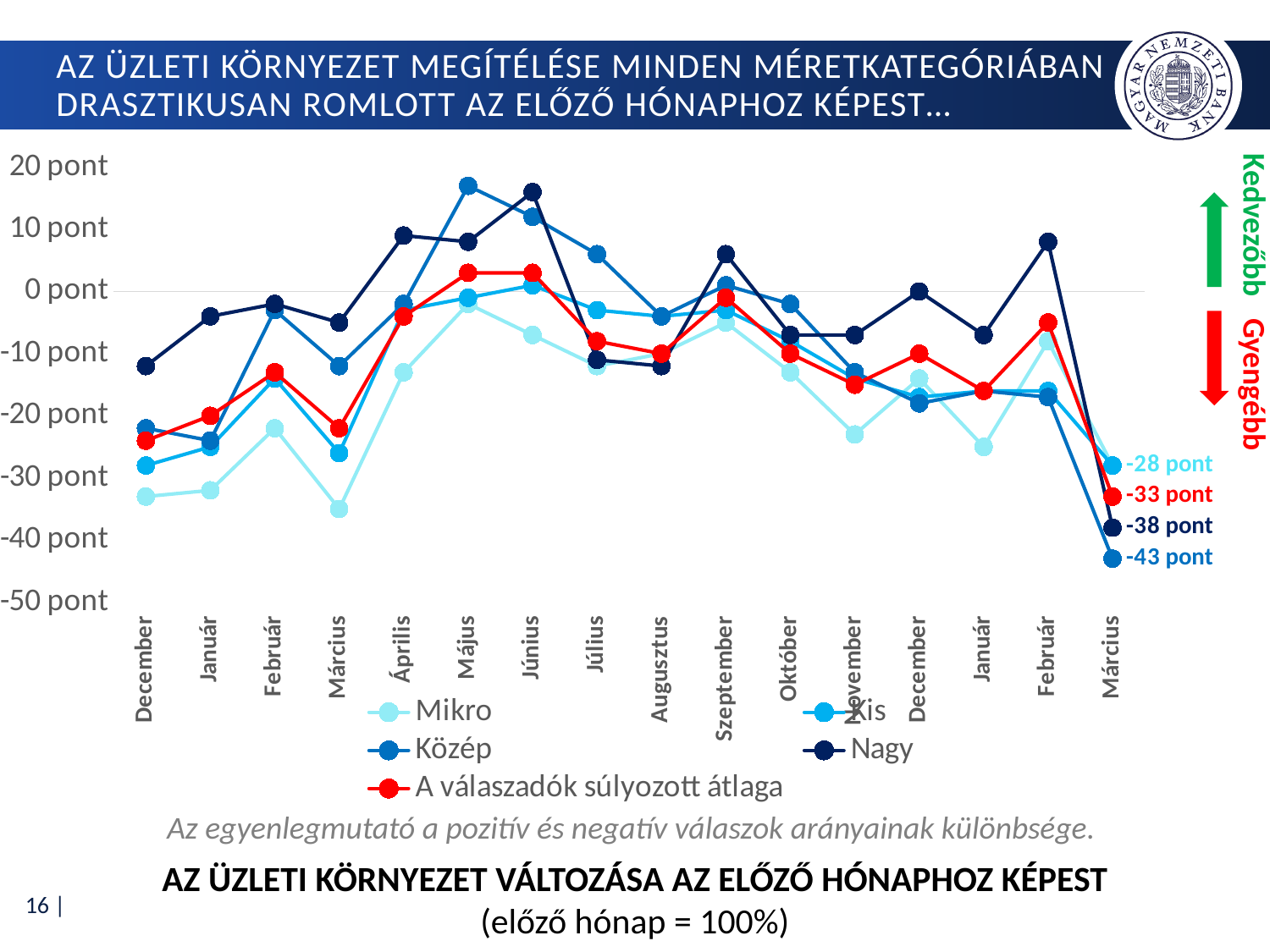
Is the value for Közép in Május greater or less than 10 pont? greater At the final Március, which is larger: the Nagy value or 'A válaszadók súlyozott átlaga'? A válaszadók súlyozott átlaga Which series has the highest value in Május? Közép How many months are shown along the x axis? 16 What is the value of 'A válaszadók súlyozott átlaga' at the final Március? -33 pont What is the highest value labelled at the final Március? -28 pont What is the value of the Nagy series at the final Március? -38 pont How many series does the legend list? 5 What kind of chart is shown on the slide? line chart What is the difference between the Nagy value (-38 pont) and the weighted average (-33 pont) at the final Március? 5 pont What is the lowest value labelled at the final Március? -43 pont Do the values of all series rise or fall from the final Február to the final Március? fall